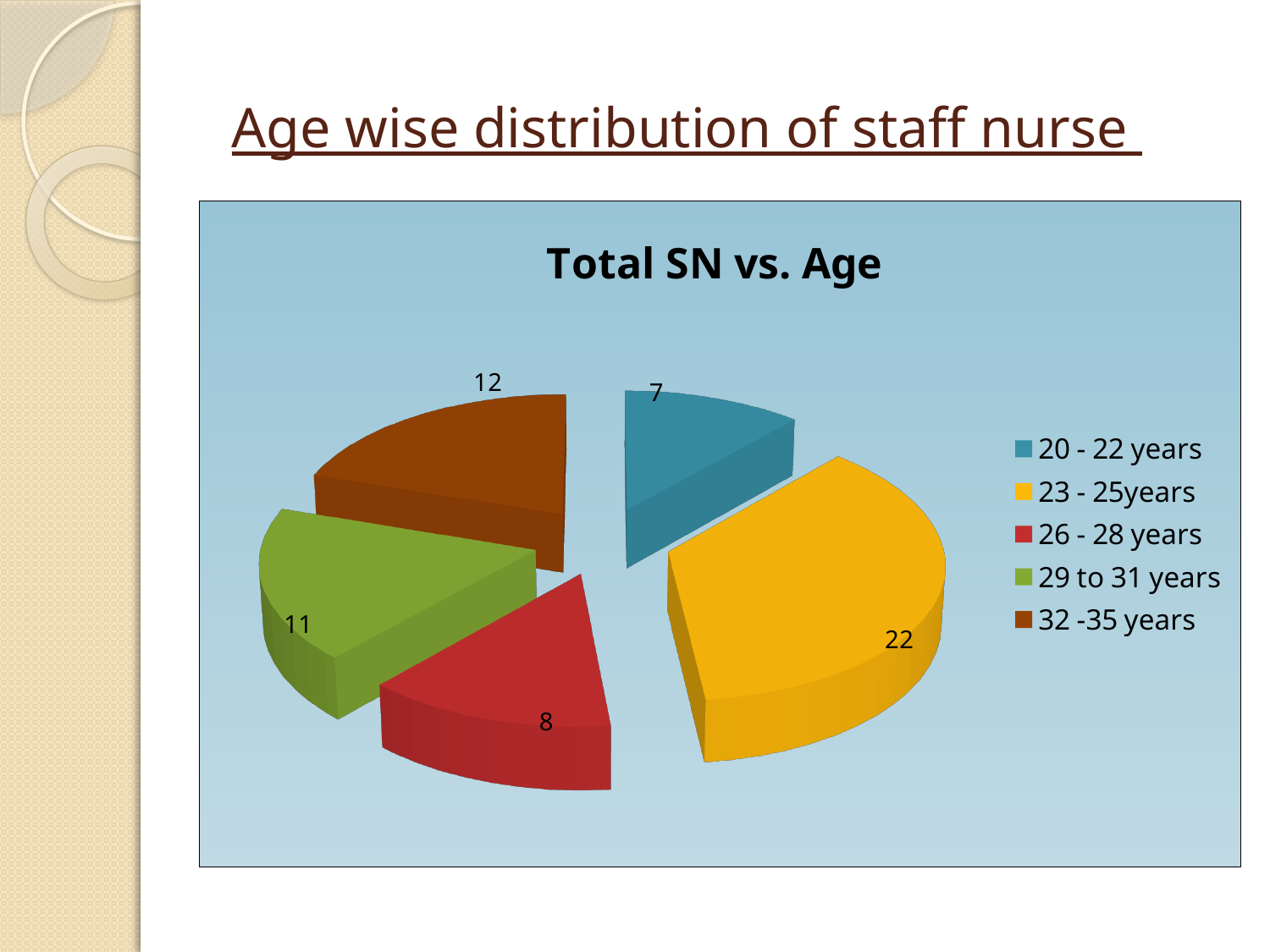
Which age group has the largest slice? 23 - 25years What is the value for the 20 - 22 years slice? 7 What share of the pie does the 32 -35 years slice represent? 20% What is the difference between the 32 -35 years value and the 26 - 28 years value? 4 What is the total of all the slices in the pie? 60 Which is larger, the value for 29 to 31 years or the value for 26 - 28 years? 29 to 31 years How many age groups does the legend list? 5 What is the value for the 23 - 25 years slice? 22 What is the chart's title? Total SN vs. Age What is the value for the 29 to 31 years slice? 11 Which age group has the smallest slice? 20 - 22 years What type of chart is shown on the slide? Pie chart